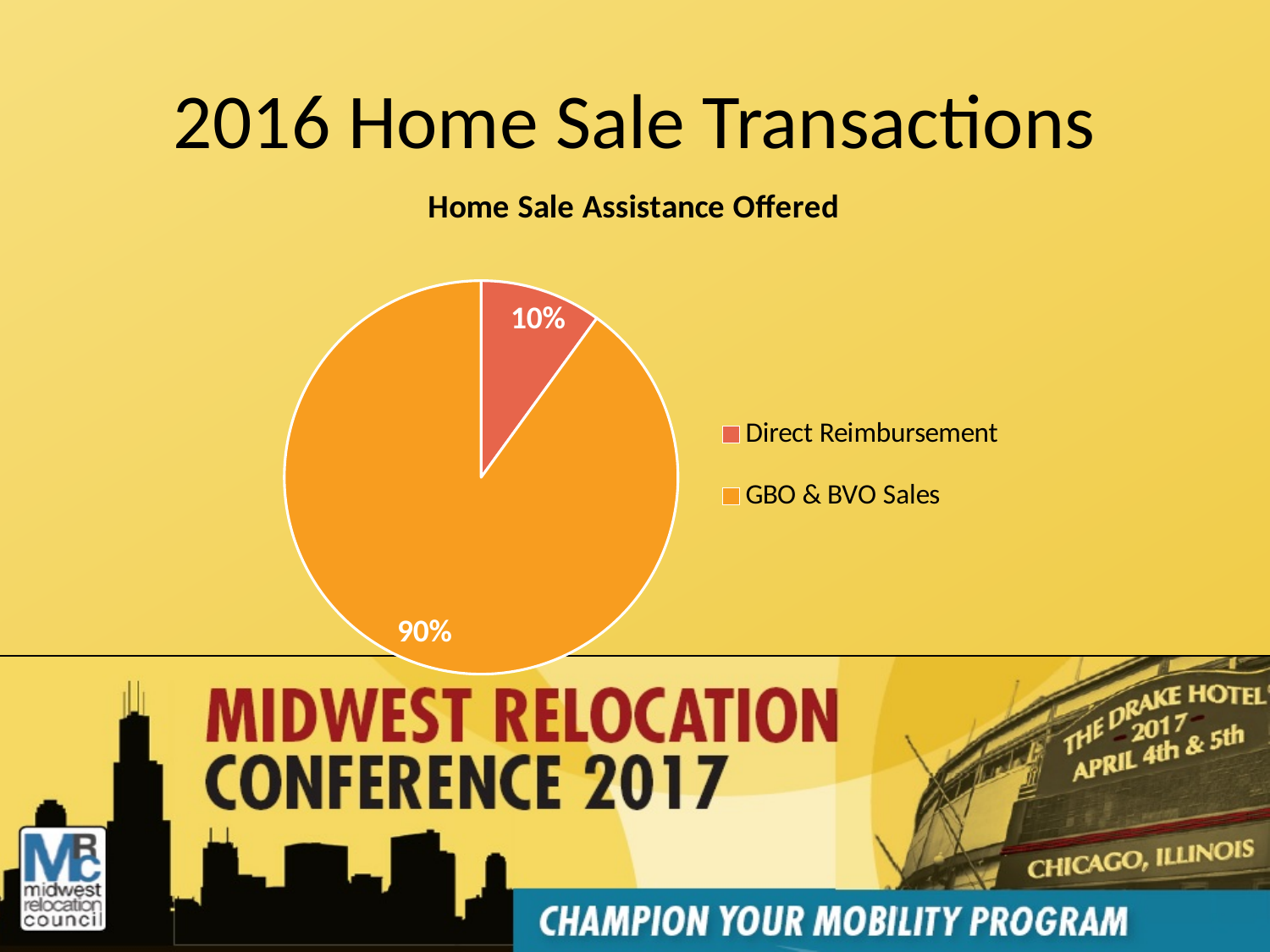
What kind of chart is shown on the slide? Pie chart What share of the pie does Direct Reimbursement represent? 10% Which category has the smallest slice of the pie? Direct Reimbursement Which is larger, the share for Direct Reimbursement or the share for GBO & BVO Sales? GBO & BVO Sales What colour is the slice for Direct Reimbursement? Red-orange What is the difference in percentage points between GBO & BVO Sales and Direct Reimbursement? 80 What is the title of the chart? Home Sale Assistance Offered How many entries does the legend list? 2 How many slices does the pie chart have? 2 Which category has the largest slice of the pie? GBO & BVO Sales What share of the pie does GBO & BVO Sales represent? 90%